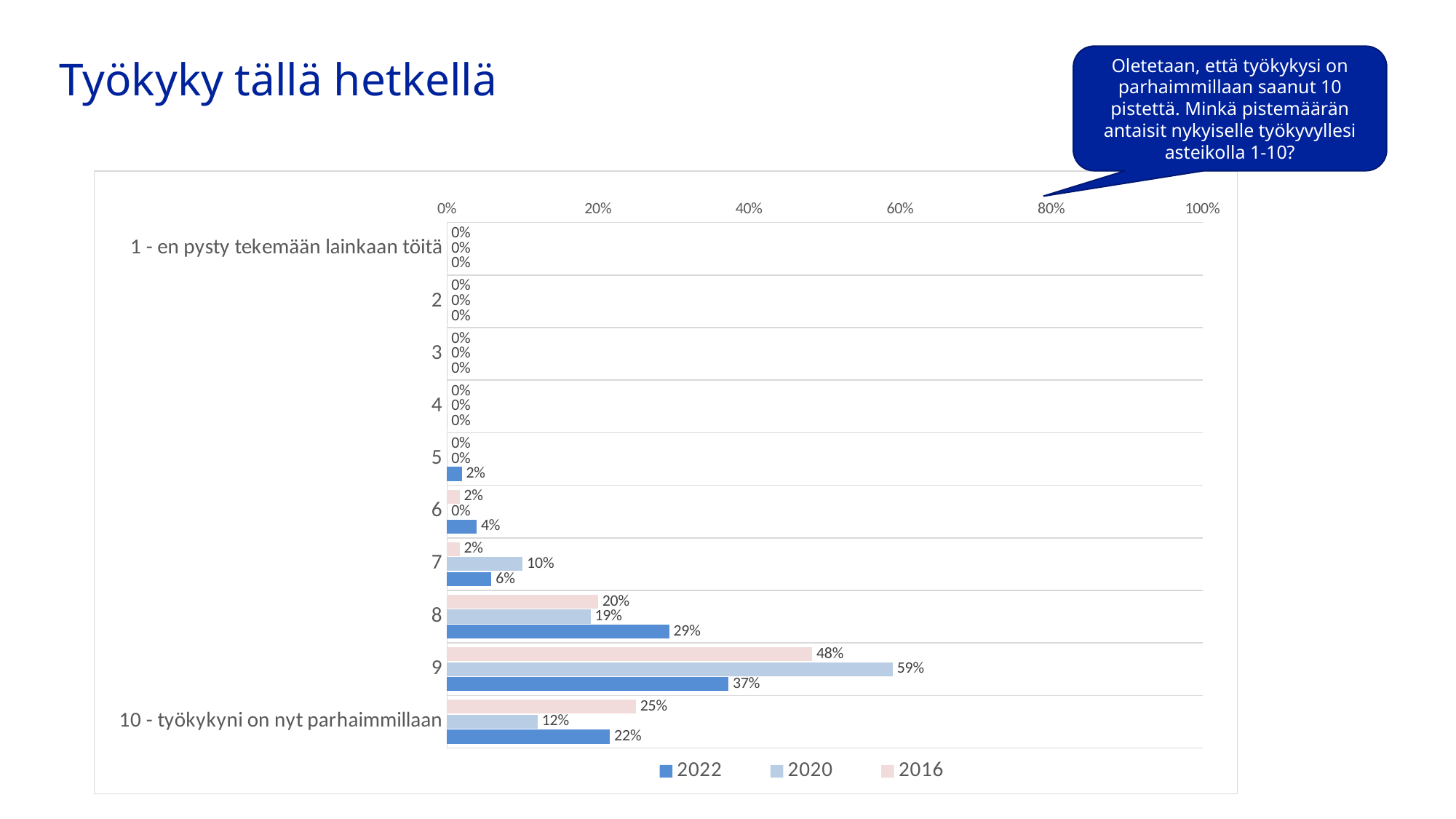
How many series does the legend list? 3 What is the title of the slide? Työkyky tällä hetkellä Which category has the highest value in the 2022 series? 9 What is the value for category 8 in the 2022 series? 29% What is the difference between the 2020 and 2022 values for category 9? 22% What is the value for '10 - työkykyni on nyt parhaimmillaan' in the 2016 series? 25% How many categories are shown on the vertical axis? 10 Which is larger for category 10: the 2022 value or the 2020 value? 2022 What kind of chart is shown on the slide? bar chart What is the value for category 9 in the 2020 series? 59% Is the value for category 9 in the 2016 series greater or less than 40%? greater What is the value for category 7 in the 2020 series? 10%